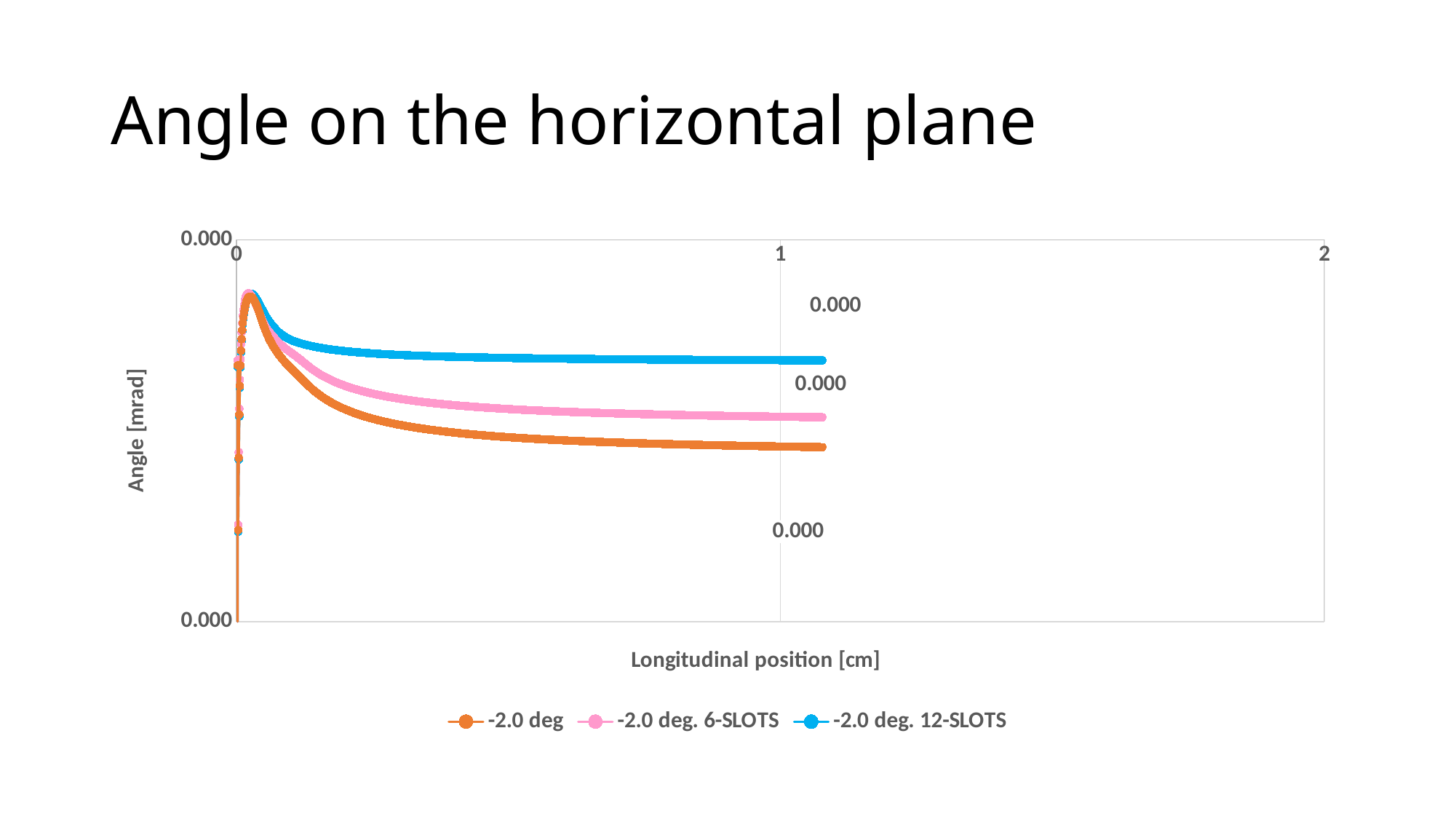
What is the largest value shown on the x axis? 2 How many series does the legend list? 3 What is the label of the x axis? Longitudinal position [cm] Do the plotted curves extend beyond a longitudinal position of 1 cm? yes At the right-hand end of the curves, which is higher: the -2.0 deg. 12-SLOTS series or the -2.0 deg. 6-SLOTS series? -2.0 deg. 12-SLOTS What kind of chart is shown on the slide? line chart What is the title of the slide's chart? Angle on the horizontal plane At the right-hand end of the curves, which is higher: the -2.0 deg. 6-SLOTS series or the -2.0 deg series? -2.0 deg. 6-SLOTS Which series is plotted highest at the right-hand end of the curves? -2.0 deg. 12-SLOTS Which series is plotted lowest at the right-hand end of the curves? -2.0 deg After reaching their peak near the start, do the three series rise or fall as the longitudinal position increases? fall